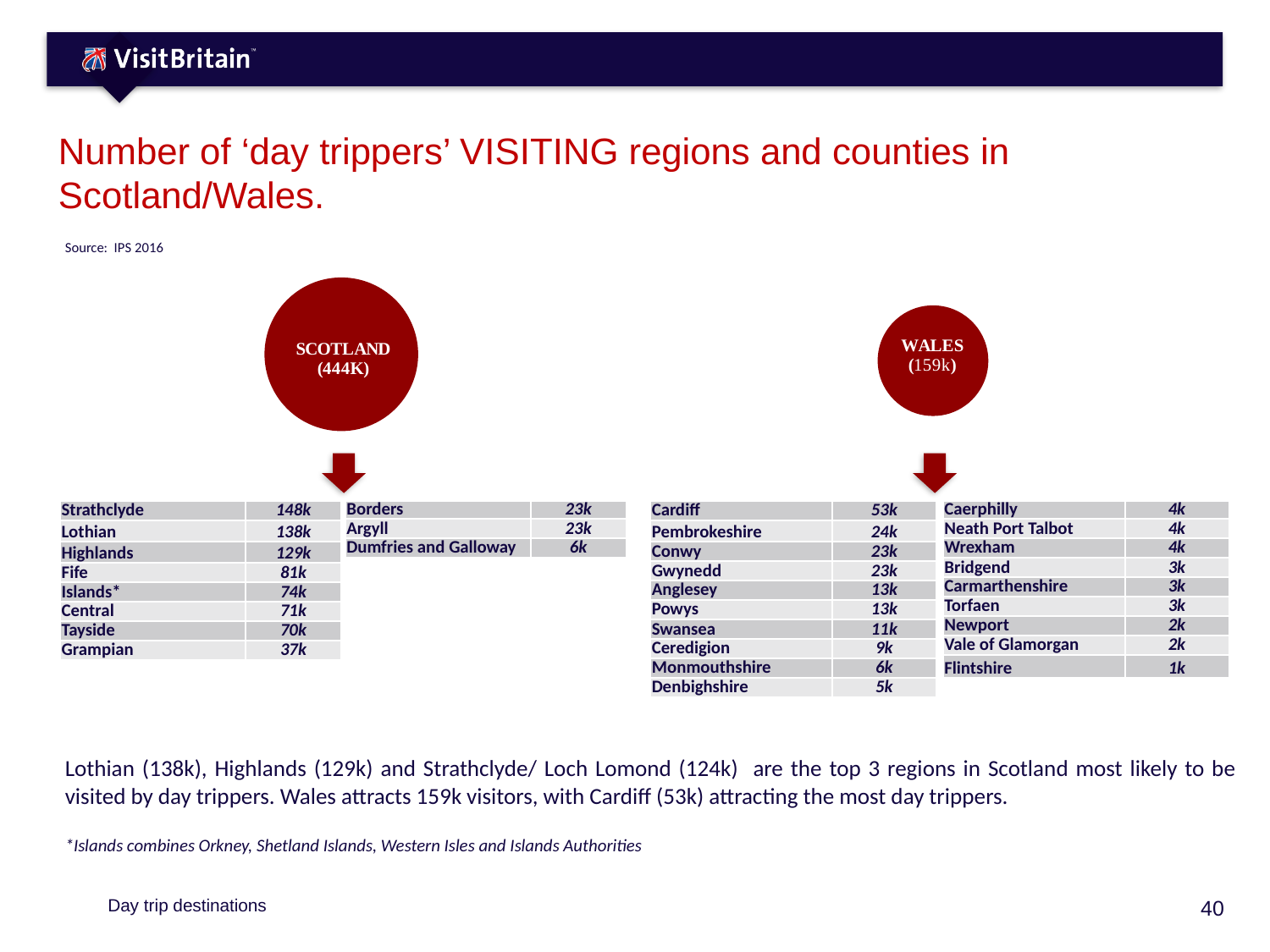
Which Scottish region has the lowest number of day trippers? Dumfries and Galloway How many day trippers are shown for Strathclyde? 148k What is the total number of day trippers shown for Wales? 159k What is the total number of day trippers shown for Scotland? 444K How many Welsh counties are listed in the tables? 19 How many day trippers are shown for Cardiff? 53k Which Scottish region has the highest number of day trippers? Strathclyde What is the difference in day trippers between Cardiff and Pembrokeshire? 29k Which Welsh county has the lowest number of day trippers? Flintshire How many Scottish regions are listed in the tables? 11 What is the source cited for the data on the slide? IPS 2016 Which has more day trippers, Lothian or Highlands? Lothian